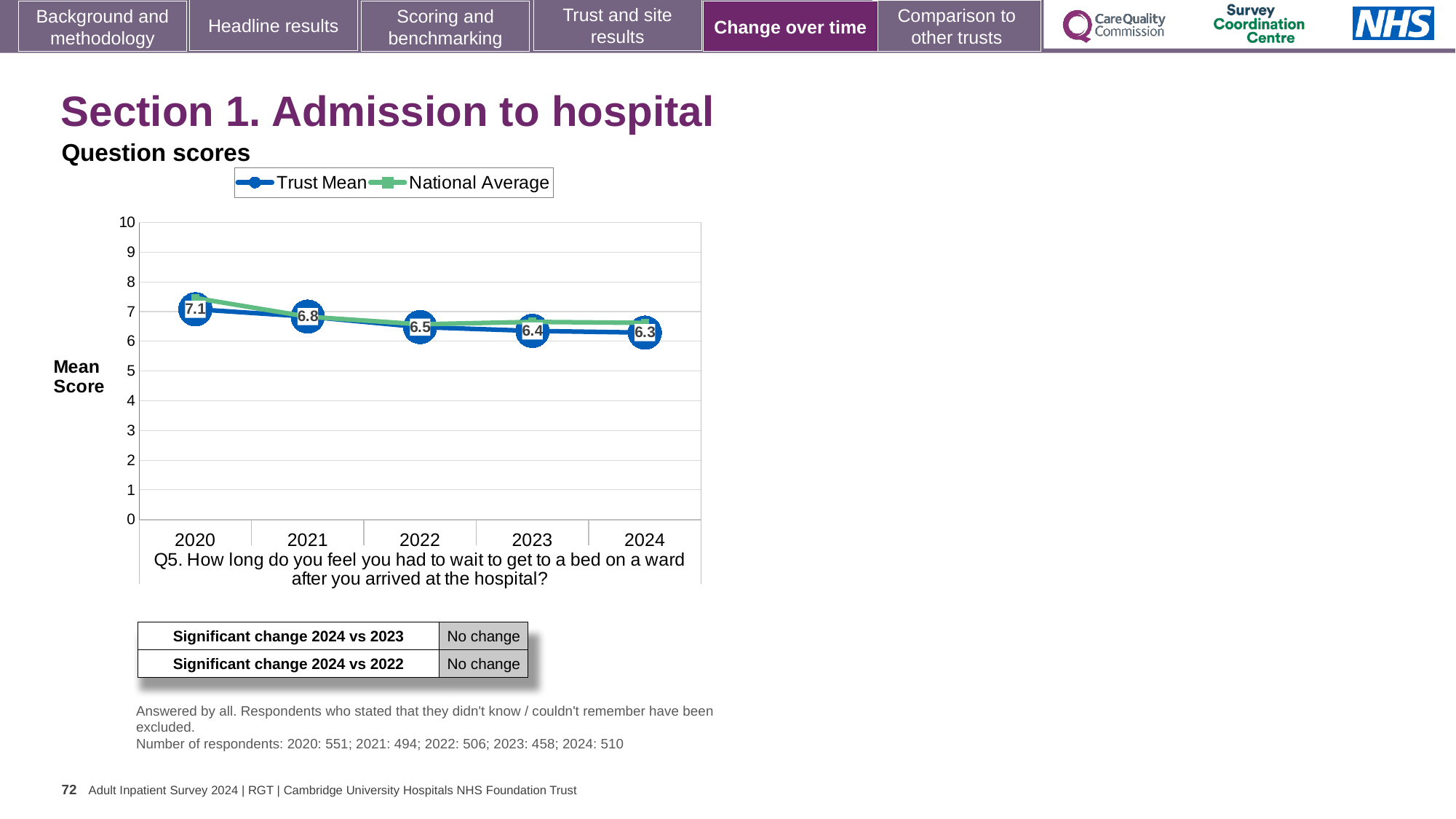
Does the Trust Mean score rise or fall from 2020 to 2024? fall What is the difference between the Trust Mean score in 2020 and in 2024? 0.8 What is the Trust Mean score for 2024? 6.3 Is the National Average value for 2020 greater or less than 7? greater What is the Trust Mean score for 2022? 6.5 Which is larger, the Trust Mean score for 2021 or for 2023? 2021 How many years are plotted on the x axis? 5 How many series does the legend list? 2 In which year is the Trust Mean score lowest? 2024 What is the Trust Mean score for 2020? 7.1 Is the National Average value for 2024 greater or less than 7? less In which year is the Trust Mean score highest? 2020